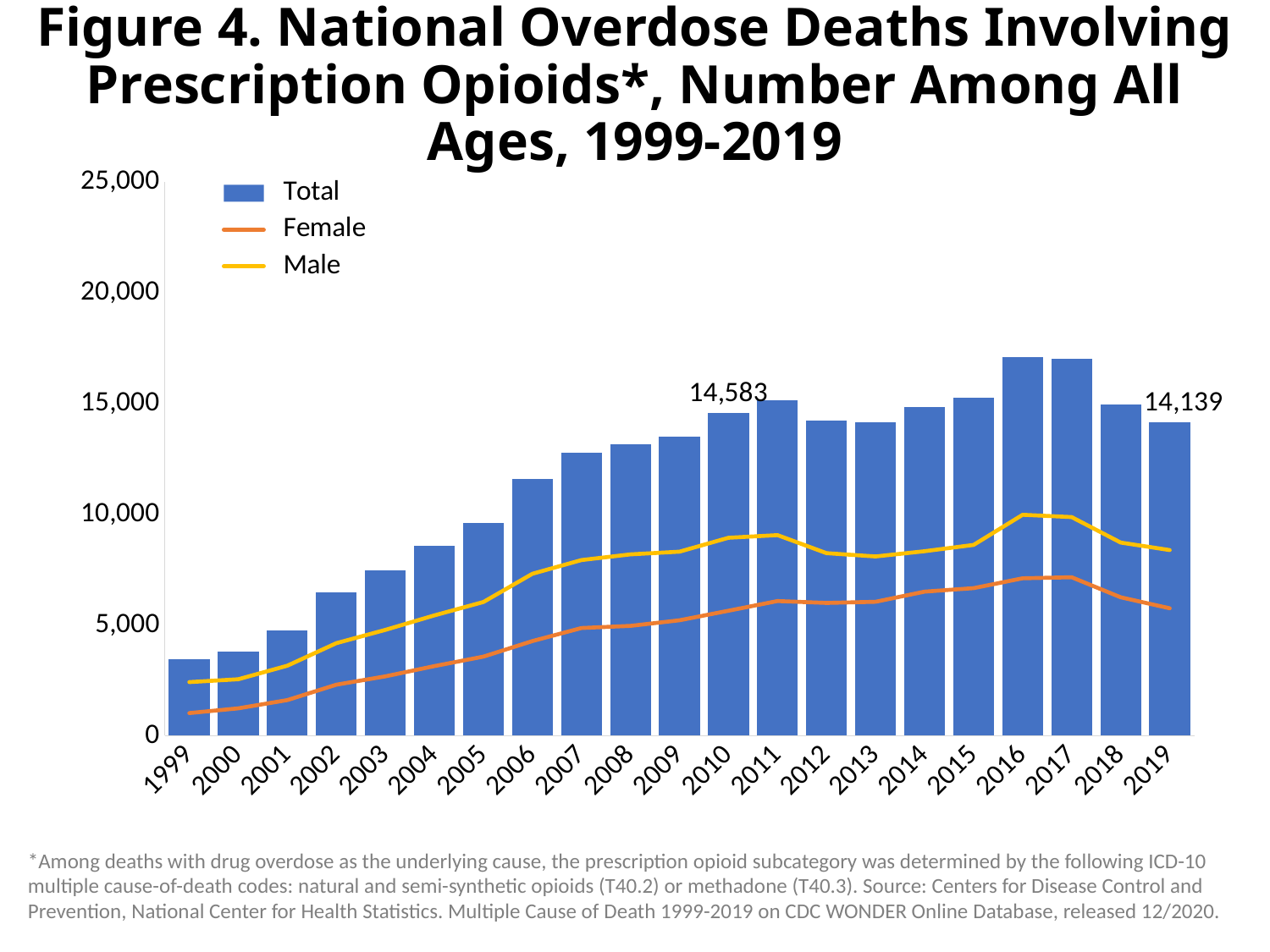
Is the total for 2005 greater or less than 10,000? less In 2010, which series has the higher value, Male or Female? Male Is the total for 2006 greater or less than 10,000? greater Is the Male value for 2019 greater or less than 10,000? less What is the total number of overdose deaths involving prescription opioids shown for 2010? 14,583 How many series does the legend list? 3 Which year has the lowest total number of deaths? 1999 What is the difference between the labelled total for 2010 and the labelled total for 2019? 444 What is the total number of overdose deaths involving prescription opioids shown for 2019? 14,139 How many years are shown on the x axis? 21 Which year has a larger labelled total, 2010 or 2019? 2010